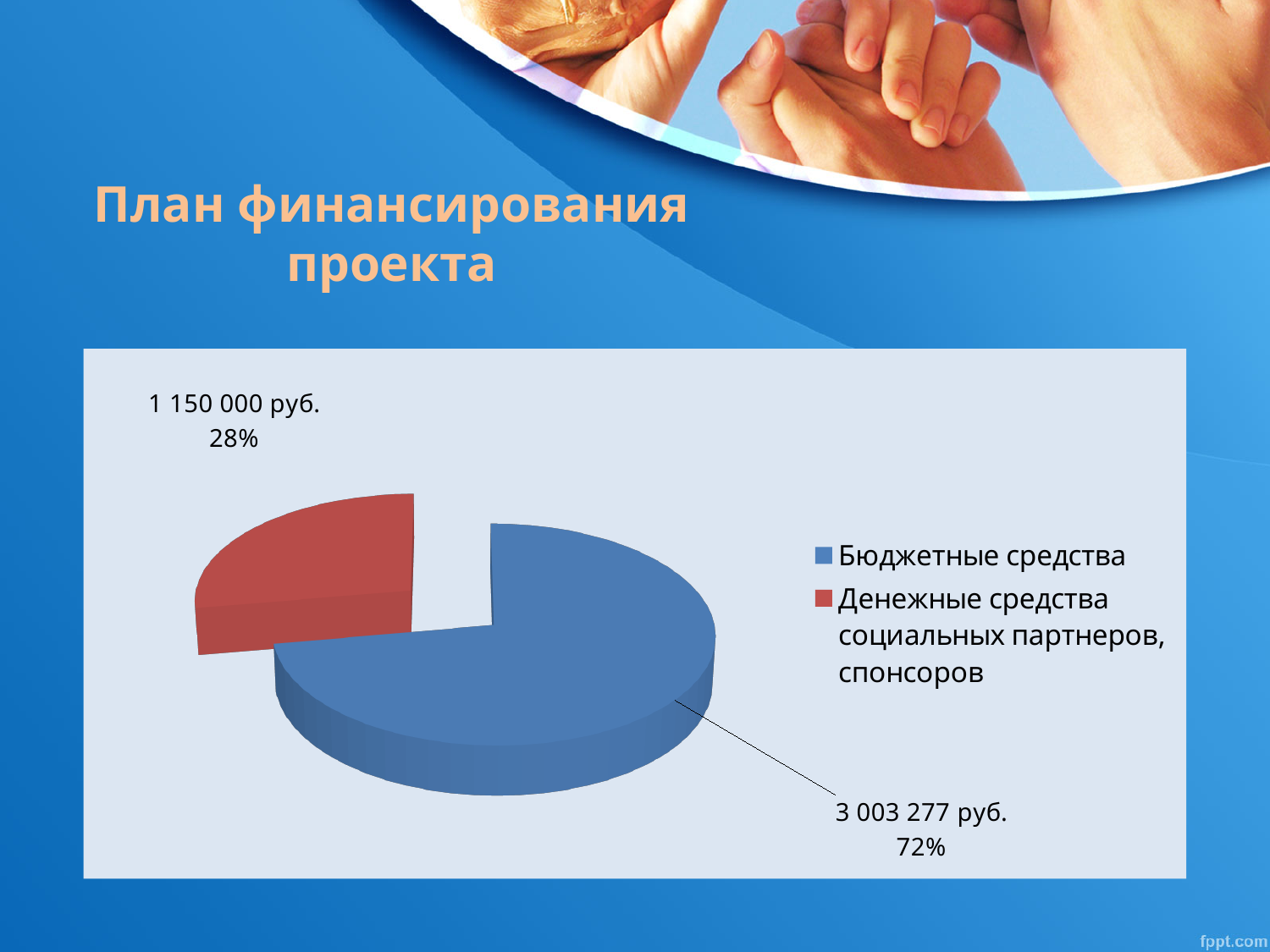
What kind of chart is shown on the slide? Pie chart How many slices does the pie chart have? 2 What is the value for Денежные средства социальных партнеров, спонсоров? 1 150 000 руб. What share of the pie does Бюджетные средства take? 72% Which is larger: Бюджетные средства or Денежные средства социальных партнеров, спонсоров? Бюджетные средства Which category has the smallest slice of the pie? Денежные средства социальных партнеров, спонсоров What colour is the slice for Бюджетные средства? Blue What share of the pie does Денежные средства социальных партнеров, спонсоров take? 28% Which category has the largest slice of the pie? Бюджетные средства What is the difference in rubles between Бюджетные средства and Денежные средства социальных партнеров, спонсоров? 1 853 277 руб. What is the title of the slide containing the chart? План финансирования проекта What is the value for Бюджетные средства? 3 003 277 руб.